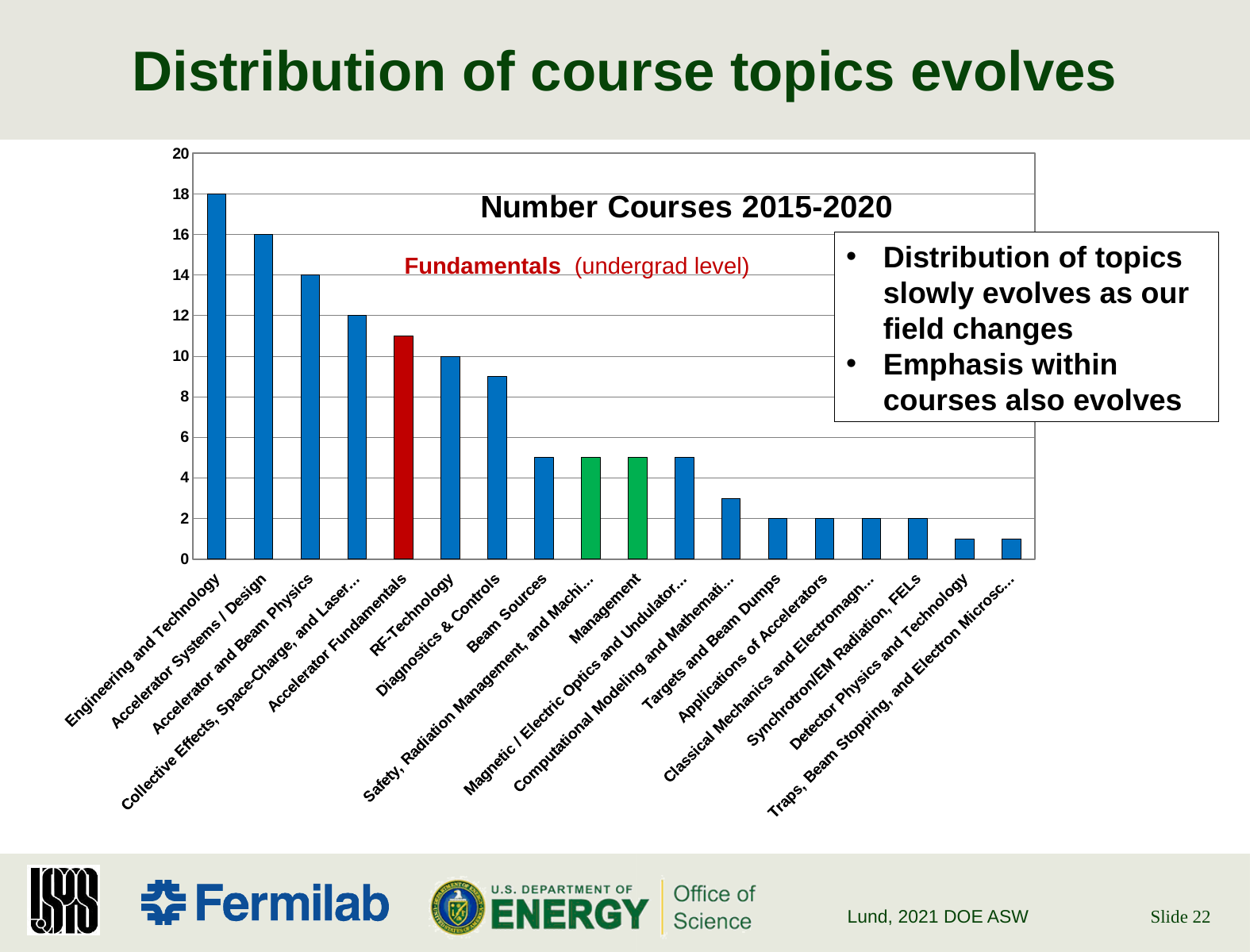
Do the values rise or fall moving from left to right along the x axis? fall What is the difference between the values for Engineering and Technology and Accelerator Systems / Design? 2 Is the value for Accelerator Fundamentals greater or less than 10? greater Which category has the highest number of courses? Engineering and Technology What is the value for RF-Technology? 10 What is the value for Accelerator Systems / Design? 16 What type of chart is shown on the slide? bar chart What is the title of the chart? Number Courses 2015-2020 How many course topic categories are plotted in the chart? 18 What is the value for Engineering and Technology? 18 What is the value for Accelerator and Beam Physics? 14 Is the value for Beam Sources greater or less than 6? less